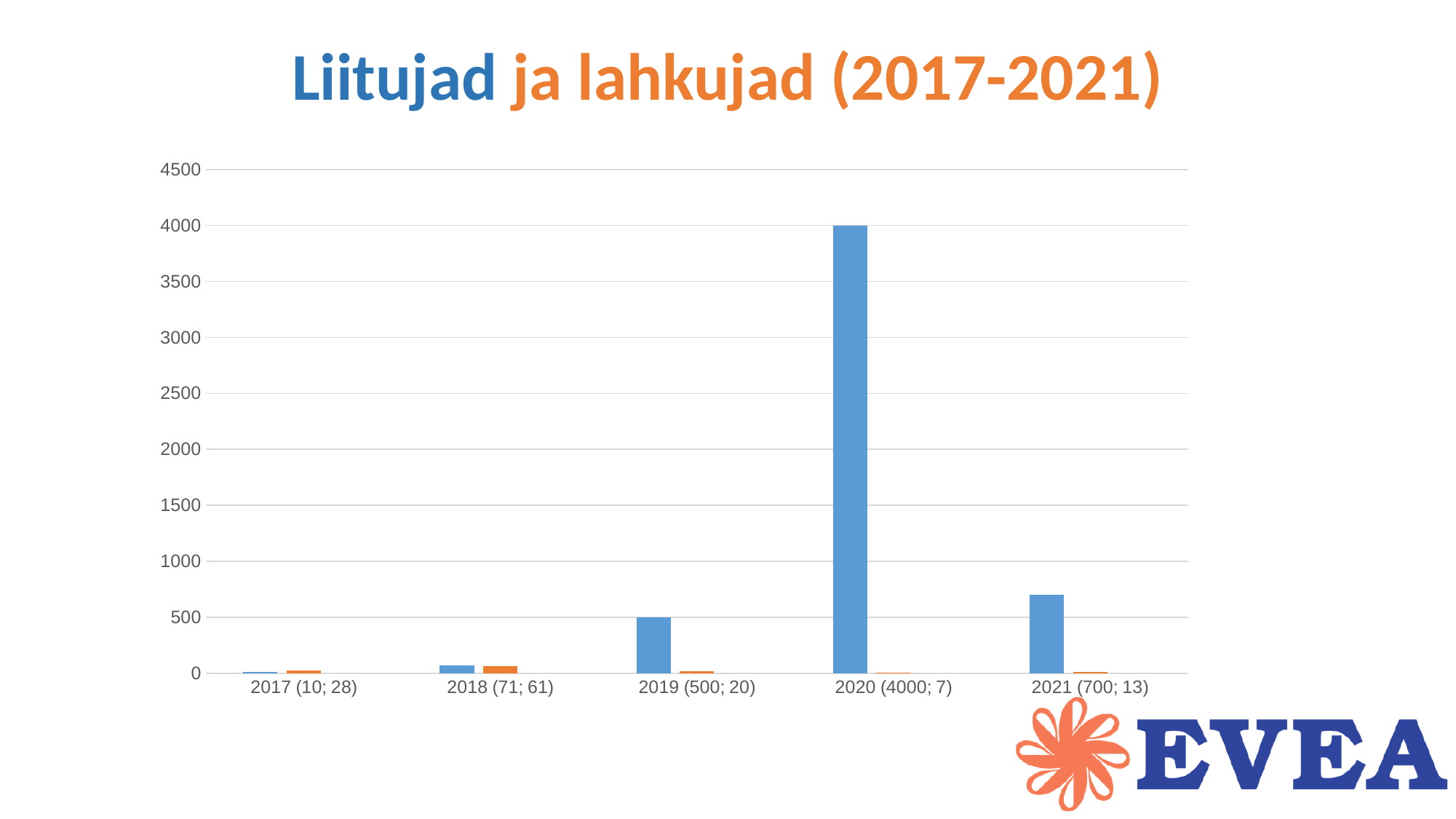
What is the value of the blue bar (liitujad) for 2021? 700 Which year has the highest blue bar (liitujad)? 2020 Do the orange bar (lahkujad) values rise or fall from 2018 to 2020? fall Which year has the lowest blue bar (liitujad)? 2017 What is the title of the chart? Liitujad ja lahkujad (2017-2021) How many years (categories) are shown on the x axis? 5 Is the blue bar value for 2019 greater or less than 1000? less What is the difference between the blue bar values for 2020 and 2021? 3300 What kind of chart is shown on the slide? bar chart Which is larger in 2017, the blue bar (liitujad) or the orange bar (lahkujad)? orange bar (lahkujad) What is the value of the blue bar (liitujad) for 2020? 4000 What is the value of the orange bar (lahkujad) for 2018? 61